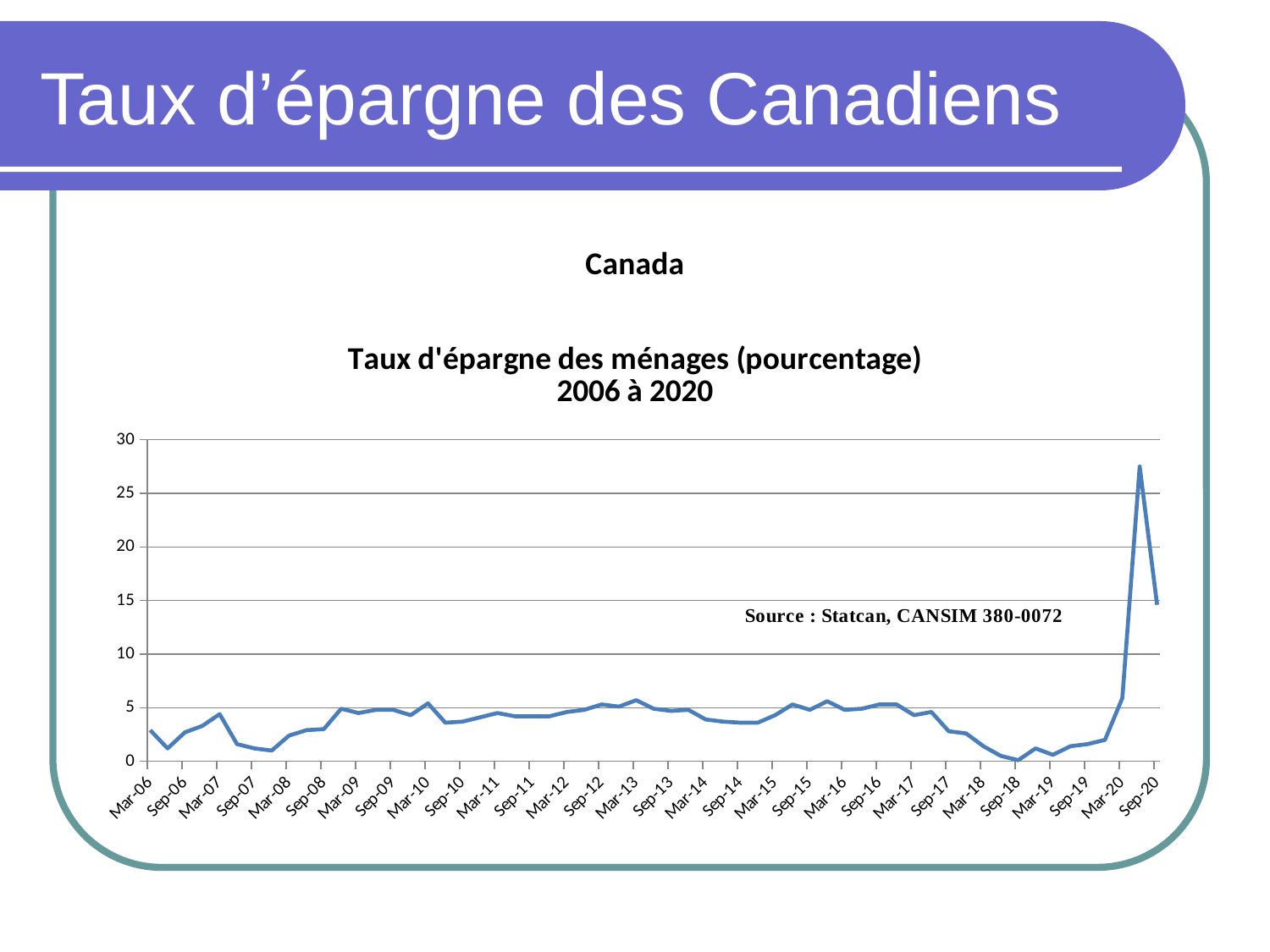
Is the value for Sep-07 greater or less than 5? less Is the value for Mar-20 greater or less than 10? less Does the household savings rate rise or fall between Mar-17 and Sep-18? fall Is the value for Sep-20 greater or less than 20? less What is the title of the chart? Canada Taux d'épargne des ménages (pourcentage) 2006 à 2020 Which is larger, the value for Mar-07 or the value for Sep-07? Mar-07 In which year does the household savings rate reach its highest value? 2020 Which labelled date on the x axis has the lowest household savings rate? Sep-18 What source is cited on the chart? Statcan, CANSIM 380-0072 What kind of chart is shown on the slide? line chart